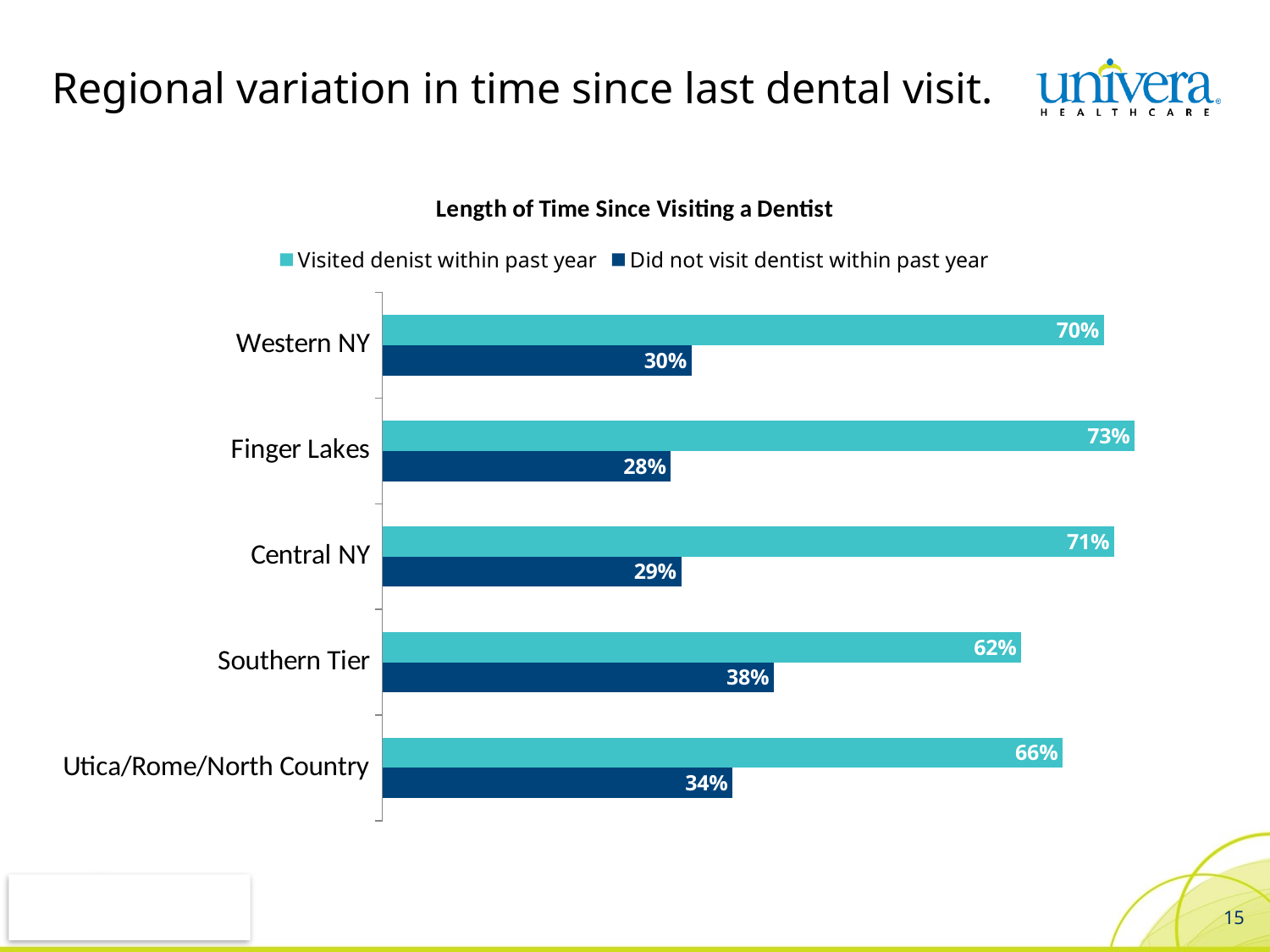
How many regions are shown in the chart? 5 What is the title of the chart? Length of Time Since Visiting a Dentist Which region has the highest percentage that visited a dentist within the past year? Finger Lakes How many series does the legend list? 2 What is the difference between the 'Visited denist within past year' and 'Did not visit dentist within past year' values for Western NY? 40% What percentage of Southern Tier respondents did not visit a dentist within the past year? 38% What is the value for Utica/Rome/North Country in the 'Visited denist within past year' series? 66% What type of chart is shown on the slide? Bar chart Which region has the lowest percentage that visited a dentist within the past year? Southern Tier Which is larger: the 'Did not visit dentist within past year' value for Central NY or for Utica/Rome/North Country? Utica/Rome/North Country Which region has the highest percentage that did not visit a dentist within the past year? Southern Tier What percentage of Finger Lakes respondents visited a dentist within the past year? 73%